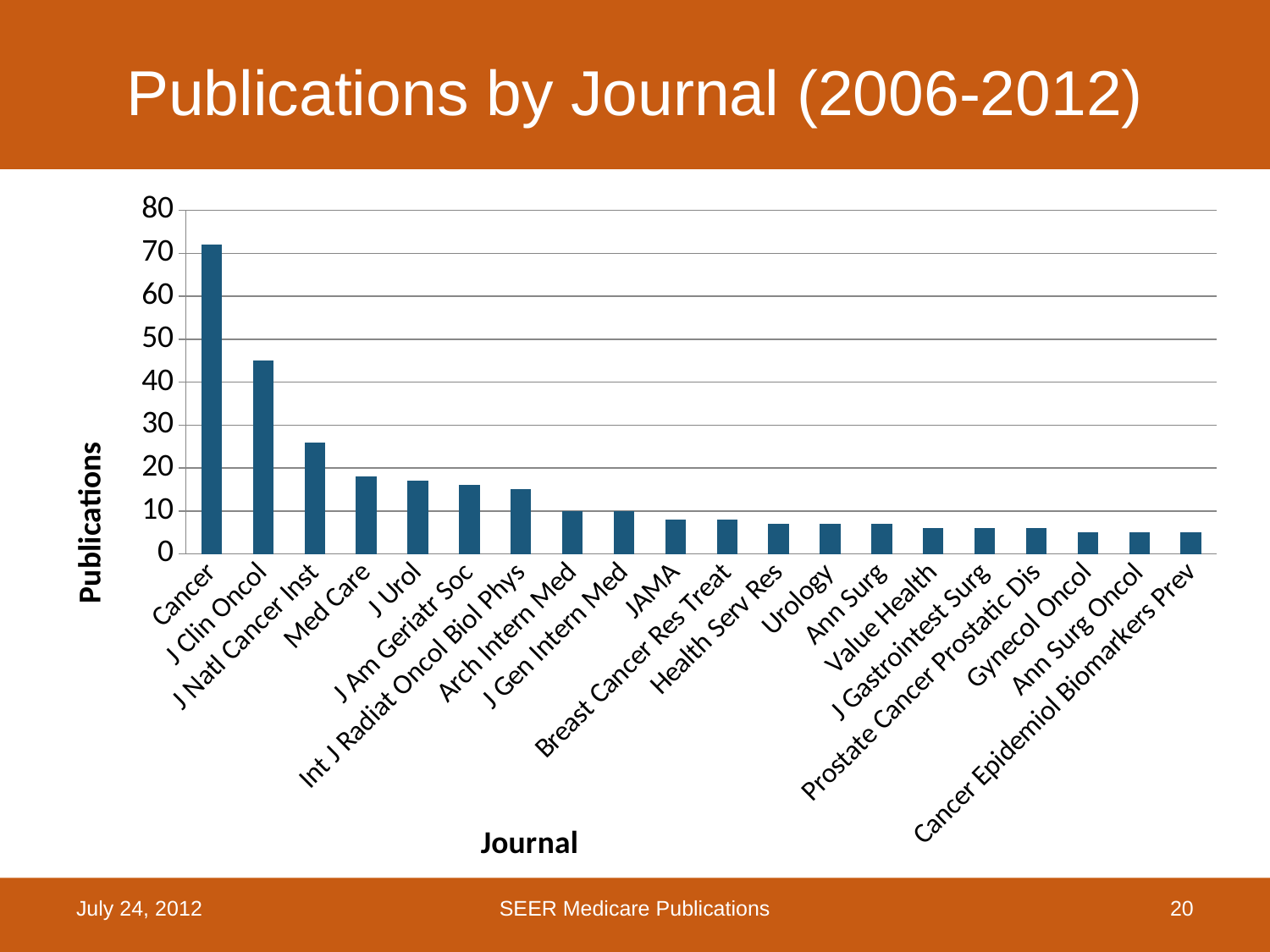
Is the value for J Clin Oncol greater or less than 40? greater Which journal has the highest number of publications? Cancer Do the values rise or fall moving from left to right along the x axis? fall Is the value for JAMA greater or less than 10? less What kind of chart is shown on the slide? bar chart What is the label of the y axis? Publications Is the value for Cancer greater or less than 70? greater Which has more publications, Med Care or Gynecol Oncol? Med Care How many journals are shown on the x axis? 20 Which has more publications, J Clin Oncol or J Natl Cancer Inst? J Clin Oncol